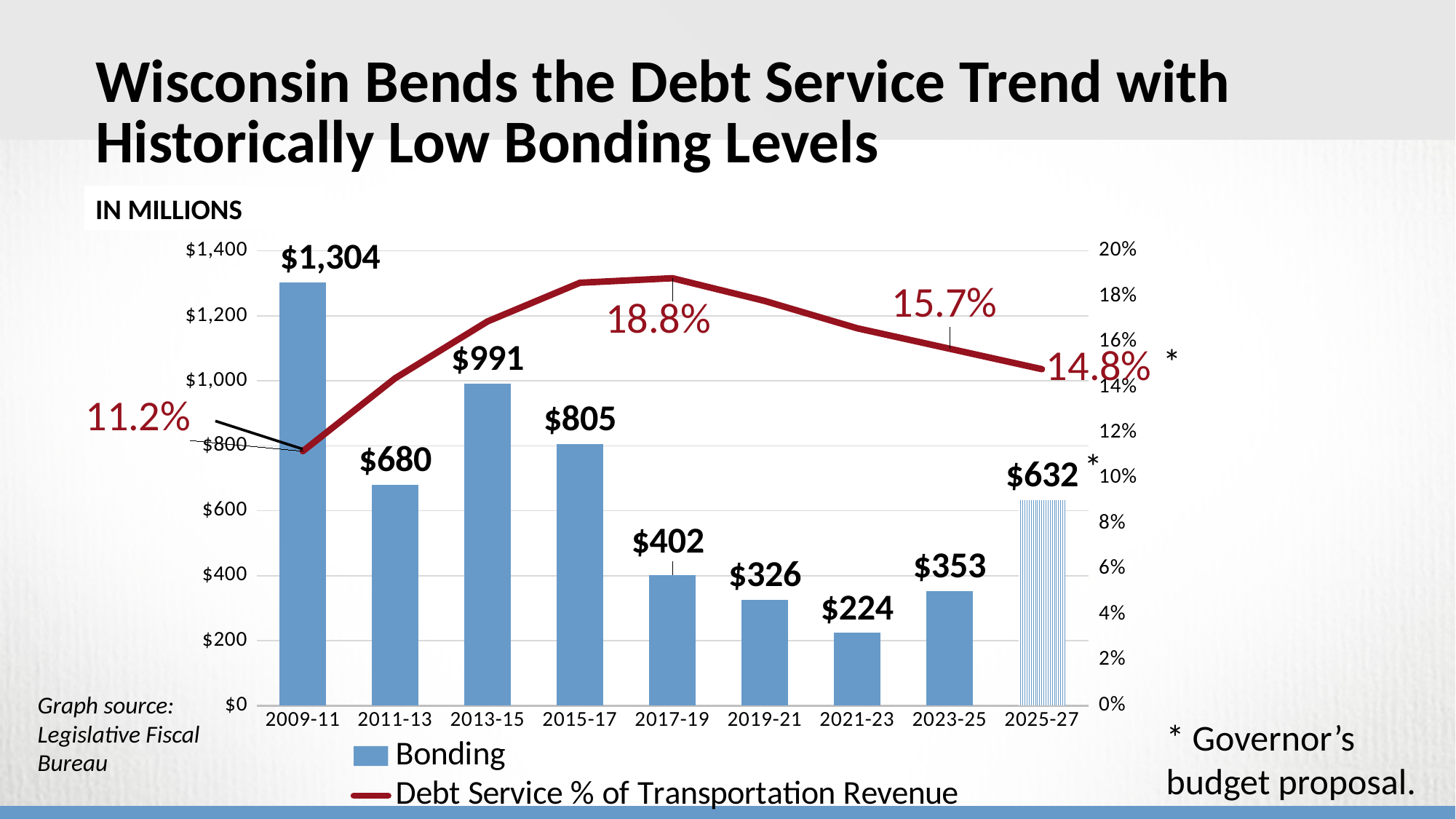
What is the Debt Service % of Transportation Revenue for 2017-19? 18.8% Is the Debt Service % of Transportation Revenue for 2013-15 greater or less than 14%? greater Which period has the lowest Bonding value? 2021-23 What is the Bonding value for 2021-23? $224 How many periods are shown on the x axis? 9 Which is larger, the Bonding value for 2019-21 or for 2023-25? 2023-25 What is the Debt Service % of Transportation Revenue for 2009-11? 11.2% Which period has the highest Bonding value? 2009-11 What is the Bonding value for 2013-15? $991 What is the difference between the Bonding values for 2009-11 and 2011-13? $624 How many series does the legend list? 2 What is the Bonding value for 2025-27? $632